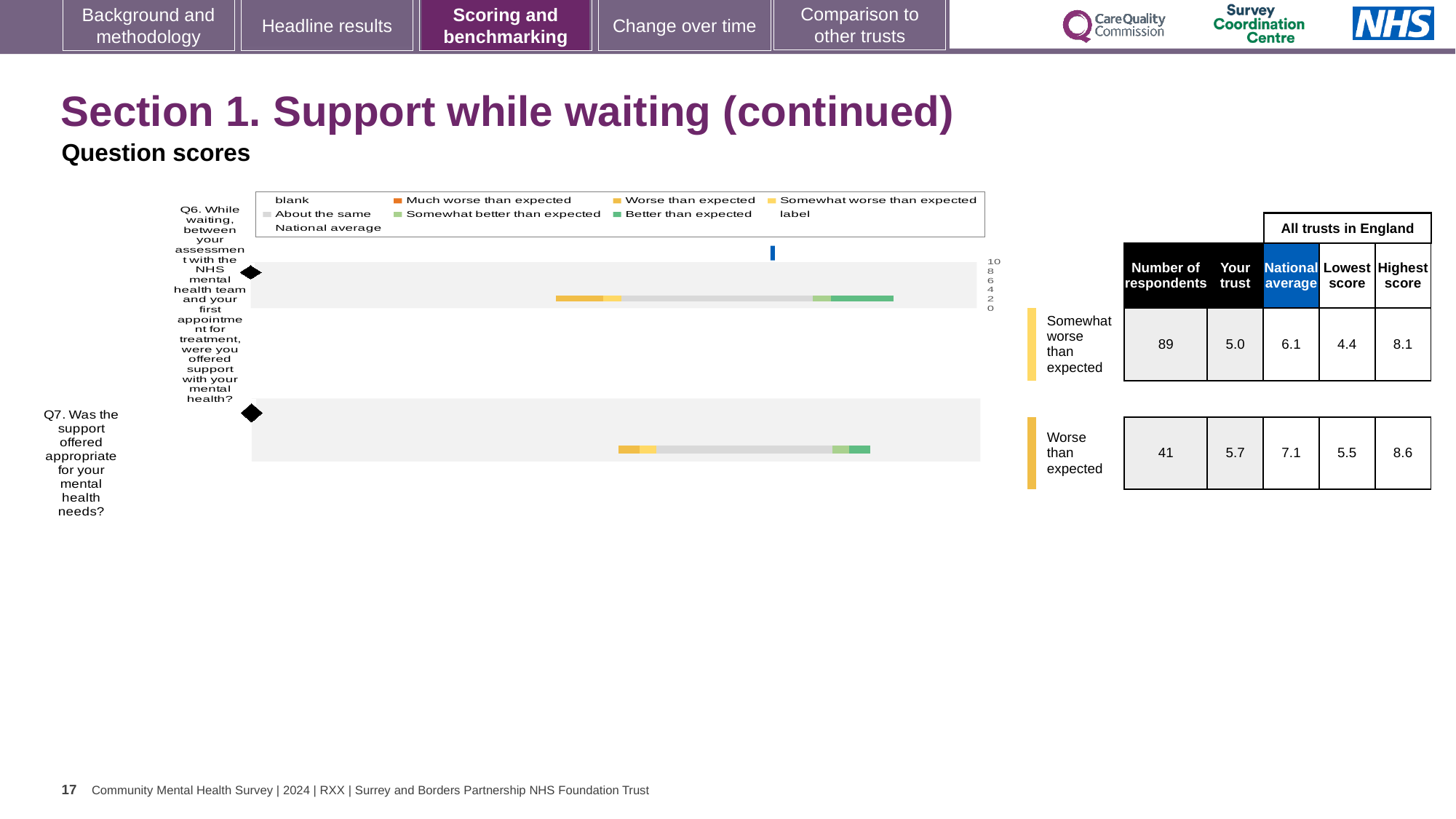
How many questions are plotted in the question scores chart? 2 What benchmark rating is shown for Q6? Somewhat worse than expected For Q7, what is the difference between the national average and the 'Your trust' score? 1.4 What kind of chart is used to show the question scores on this slide? bar chart What benchmark rating is shown for Q7? Worse than expected What is the lowest score among all trusts in England for Q6? 4.4 What is the highest score among all trusts in England for Q7? 8.6 What is the 'Your trust' score for Q6 (support with mental health while waiting)? 5.0 Which question has the higher number of respondents, Q6 or Q7? Q6 What is the national average score for Q7 (was the support offered appropriate)? 7.1 How many respondents answered Q6? 89 For Q6, which is larger: the 'Your trust' score or the national average? National average